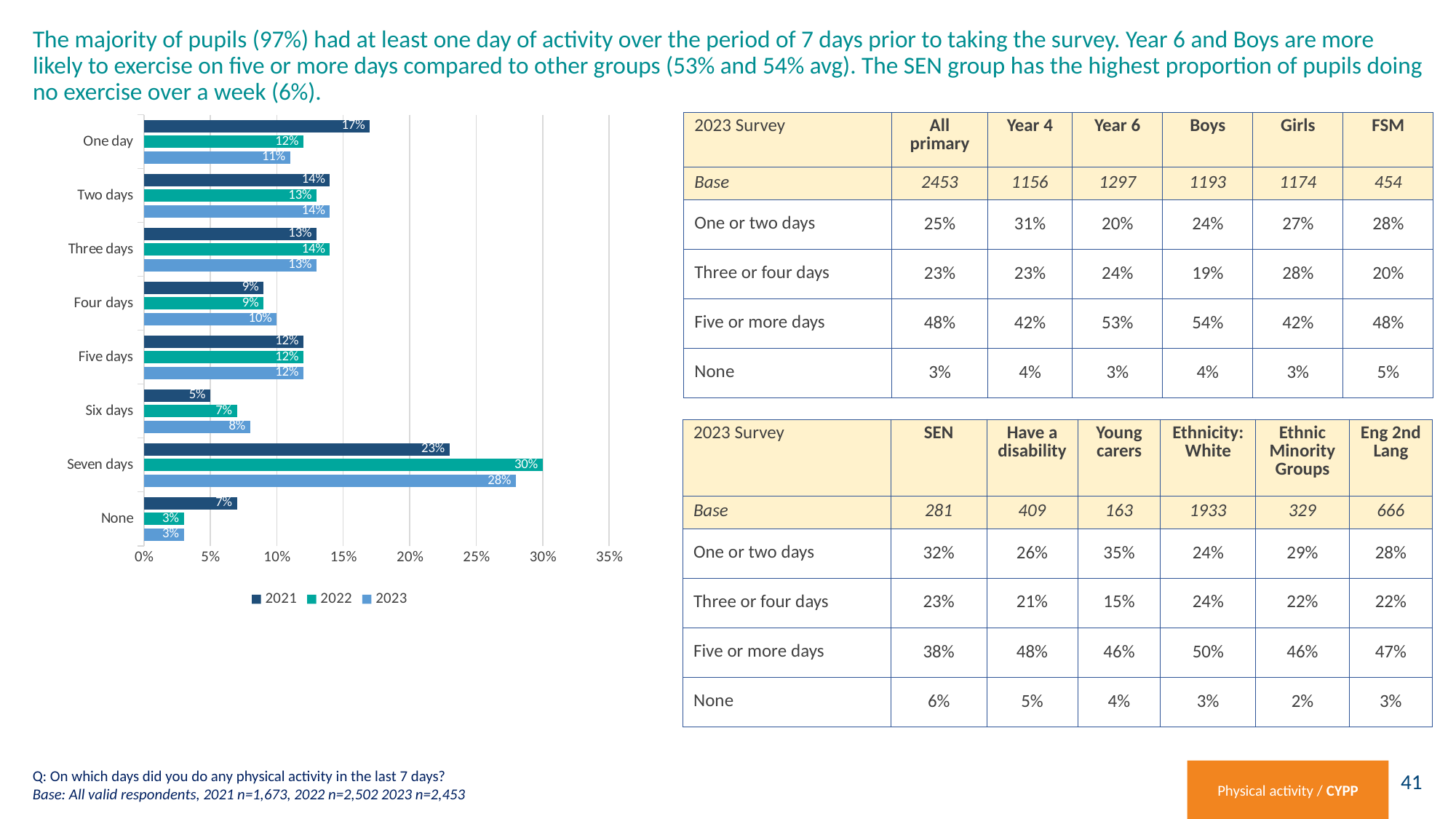
What is the 2022 value for Six days? 7% What kind of chart is shown on the left of the slide? bar chart Which category has the highest 2022 value? Seven days Which category has the lowest 2021 value? Six days Is the 2022 value for Seven days greater or less than 25%? greater Which series is shown in the darkest blue colour in the legend? 2021 How many categories are shown on the chart's vertical axis? 8 Which is larger for None: the 2021 value or the 2023 value? 2021 What is the 2023 value for Seven days? 28% What is the difference between the 2022 and 2021 values for Seven days? 7% What is the 2021 value for One day? 17% How many series does the chart legend list? 3